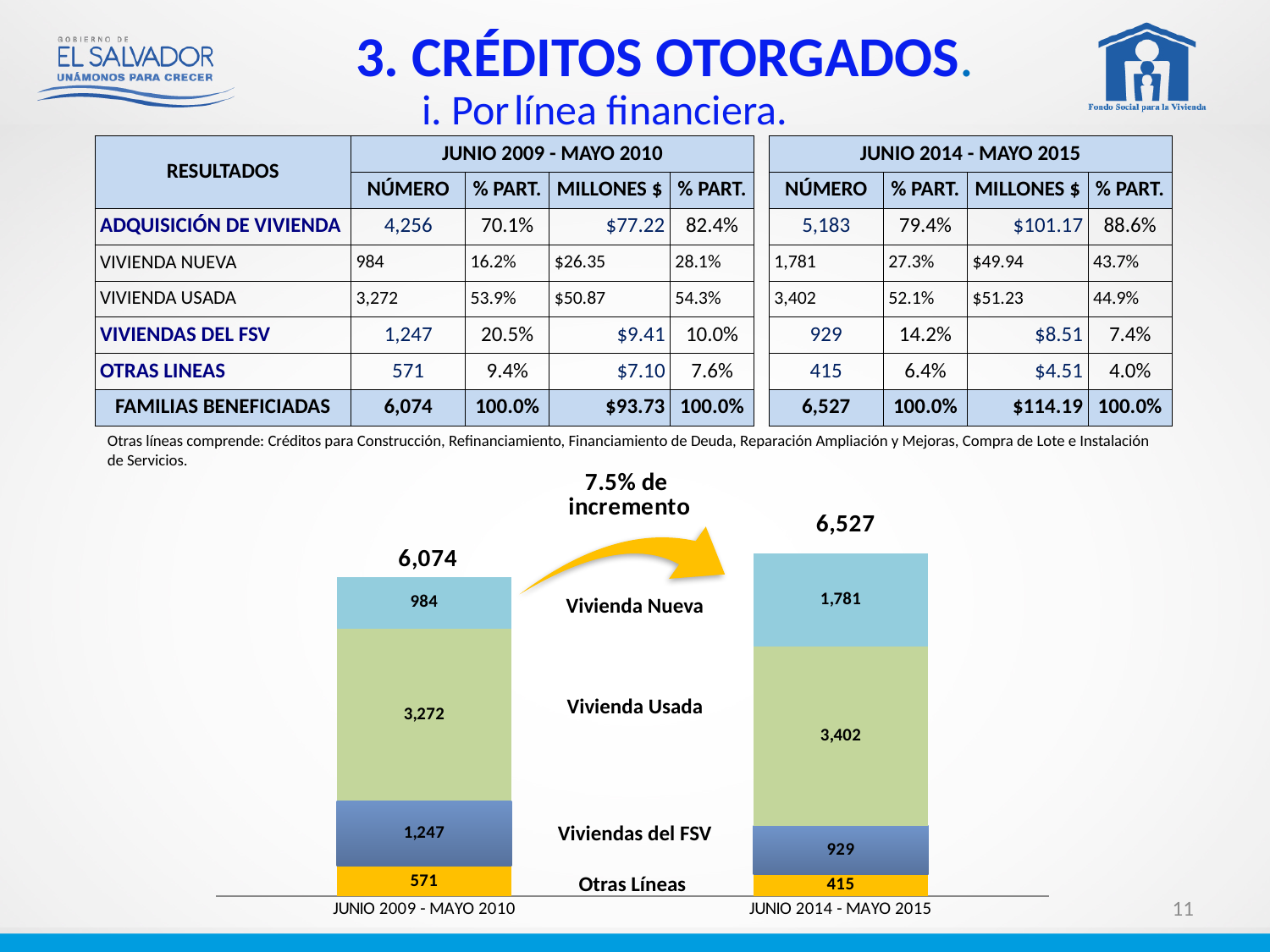
How many bars (periods) does the chart show? 2 What is the value of the Viviendas del FSV segment for JUNIO 2014 - MAYO 2015? 929 What is the value of the Otras Líneas segment for JUNIO 2009 - MAYO 2010? 571 What is the value of the Vivienda Nueva segment for JUNIO 2014 - MAYO 2015? 1,781 What is the total of the stacked bar for JUNIO 2014 - MAYO 2015? 6,527 Which period has the larger Viviendas del FSV value, JUNIO 2009 - MAYO 2010 or JUNIO 2014 - MAYO 2015? JUNIO 2009 - MAYO 2010 What is the total of the stacked bar for JUNIO 2009 - MAYO 2010? 6,074 Which segment is the largest in the JUNIO 2014 - MAYO 2015 bar? Vivienda Usada Which segment is the smallest in the JUNIO 2009 - MAYO 2010 bar? Otras Líneas What is the value of the Vivienda Usada segment for JUNIO 2009 - MAYO 2010? 3,272 What is the difference between the Vivienda Nueva values for JUNIO 2014 - MAYO 2015 and JUNIO 2009 - MAYO 2010? 797 What kind of chart is shown on the slide? stacked bar chart